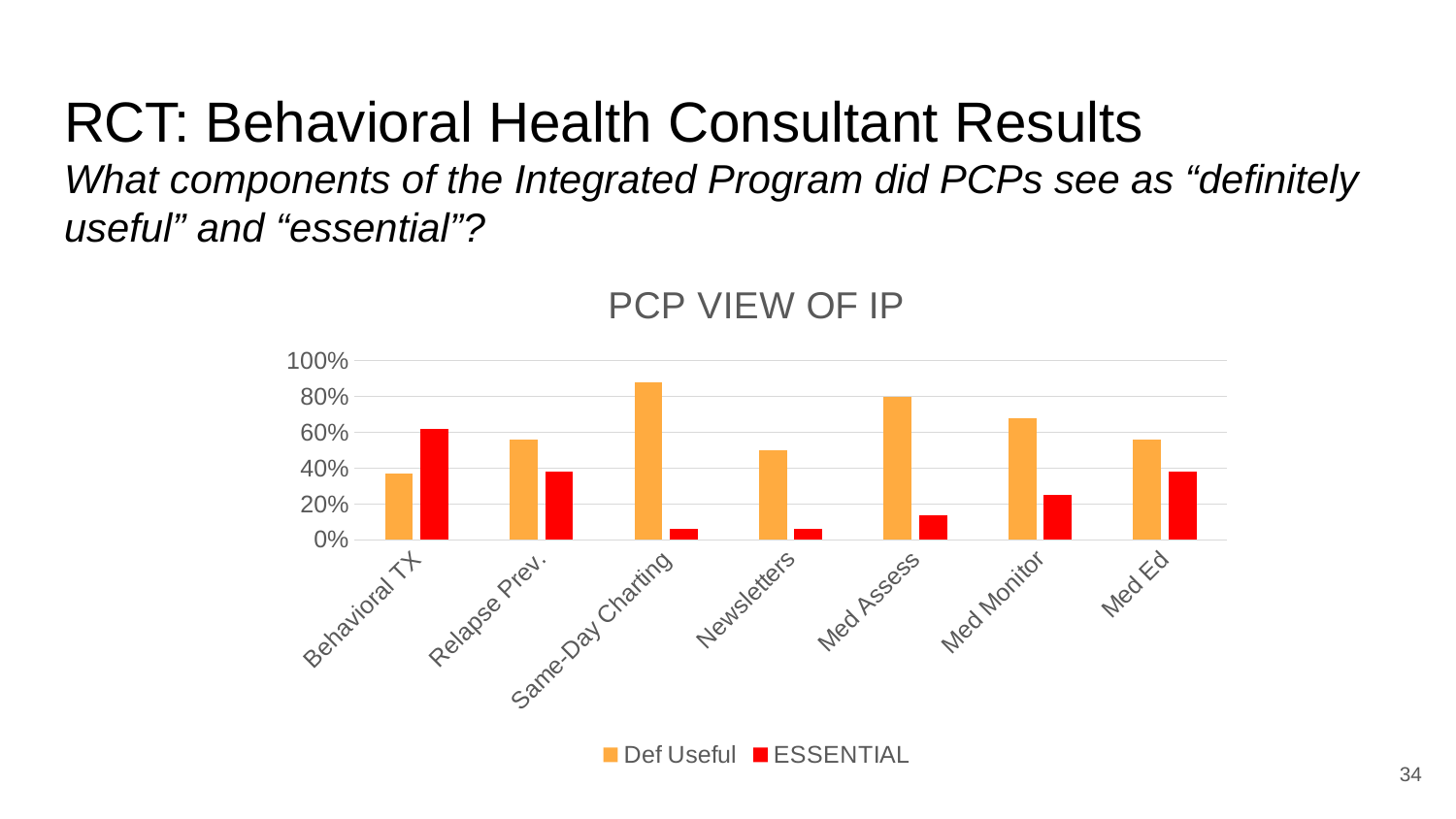
How many series does the chart's legend list? 2 Which is larger: the Def Useful value for Same-Day Charting or the Def Useful value for Med Monitor? Same-Day Charting Which component has the highest ESSENTIAL value? Behavioral TX Is the Def Useful value for Med Monitor greater or less than 60%? greater Is the Def Useful value for Same-Day Charting greater or less than 80%? greater Is the ESSENTIAL value for Med Monitor greater or less than 40%? less Which component has the lowest Def Useful value? Behavioral TX What kind of chart is shown on the slide? bar chart How many program components (categories) are shown on the x axis of the chart? 7 What is the title of the chart? PCP VIEW OF IP For Behavioral TX, which is larger: the Def Useful value or the ESSENTIAL value? ESSENTIAL Which component has the highest Def Useful value? Same-Day Charting